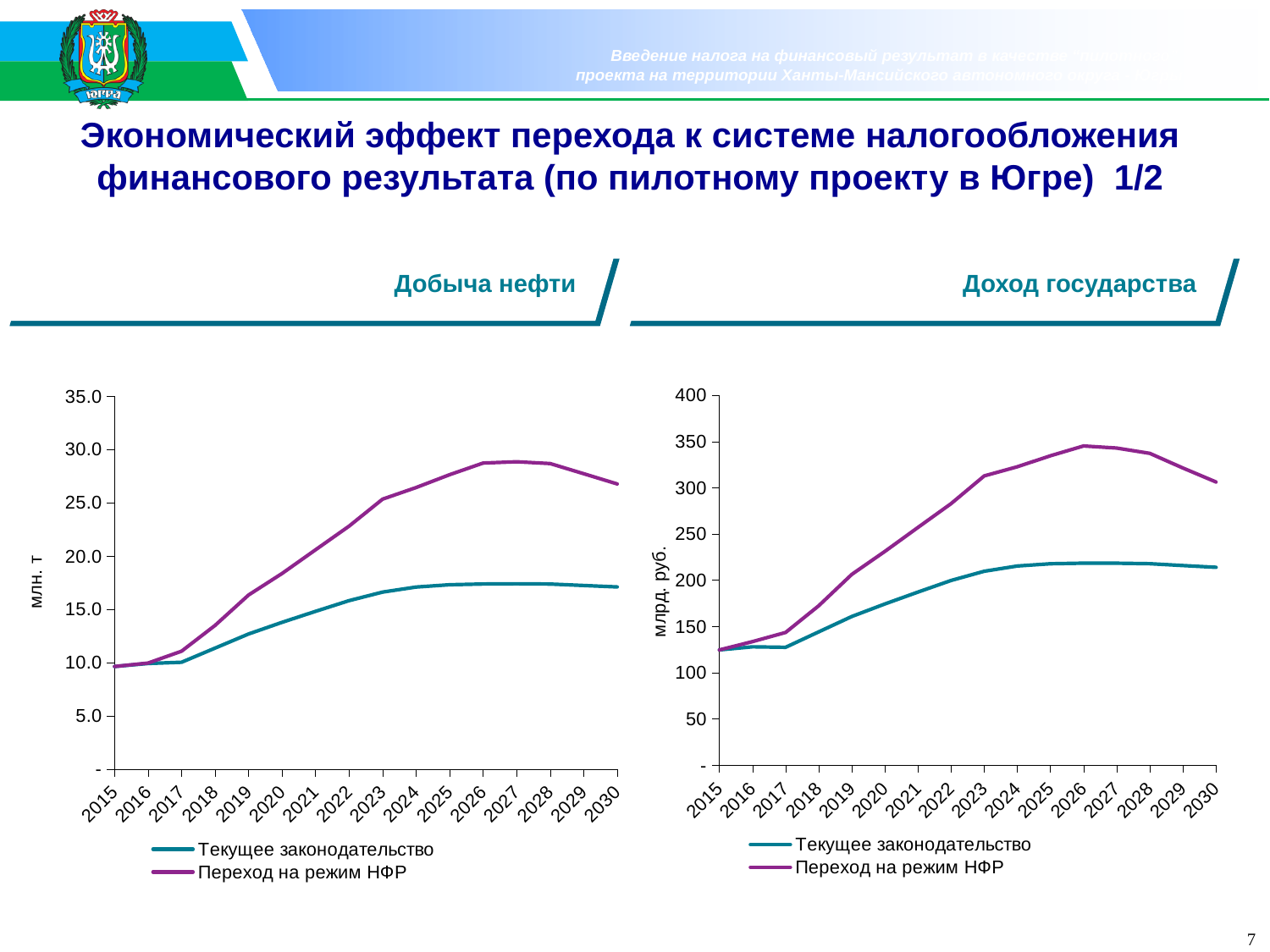
In the "Доход государства" chart, is the value for "Текущее законодательство" in 2015 greater or less than 150? less In the "Добыча нефти" chart, which series has the higher value in 2030, "Текущее законодательство" or "Переход на режим НФР"? Переход на режим НФР In the "Добыча нефти" chart, does the "Текущее законодательство" line rise or fall from 2015 to 2026? rise In the "Добыча нефти" chart, is the value for "Переход на режим НФР" in 2027 greater or less than 25.0? greater How many series does the legend of the "Доход государства" chart list? 2 In the "Доход государства" chart, is the value for "Переход на режим НФР" in 2026 greater or less than 300? greater In the "Доход государства" chart, which series has the higher value in 2025, "Текущее законодательство" or "Переход на режим НФР"? Переход на режим НФР In the "Доход государства" chart, does the "Переход на режим НФР" line rise or fall from 2026 to 2030? fall What kind of chart is the "Добыча нефти" chart on the left? line chart How many years are shown on the x axis of the "Добыча нефти" chart? 16 What is the y-axis unit label on the "Доход государства" chart? млрд. руб.